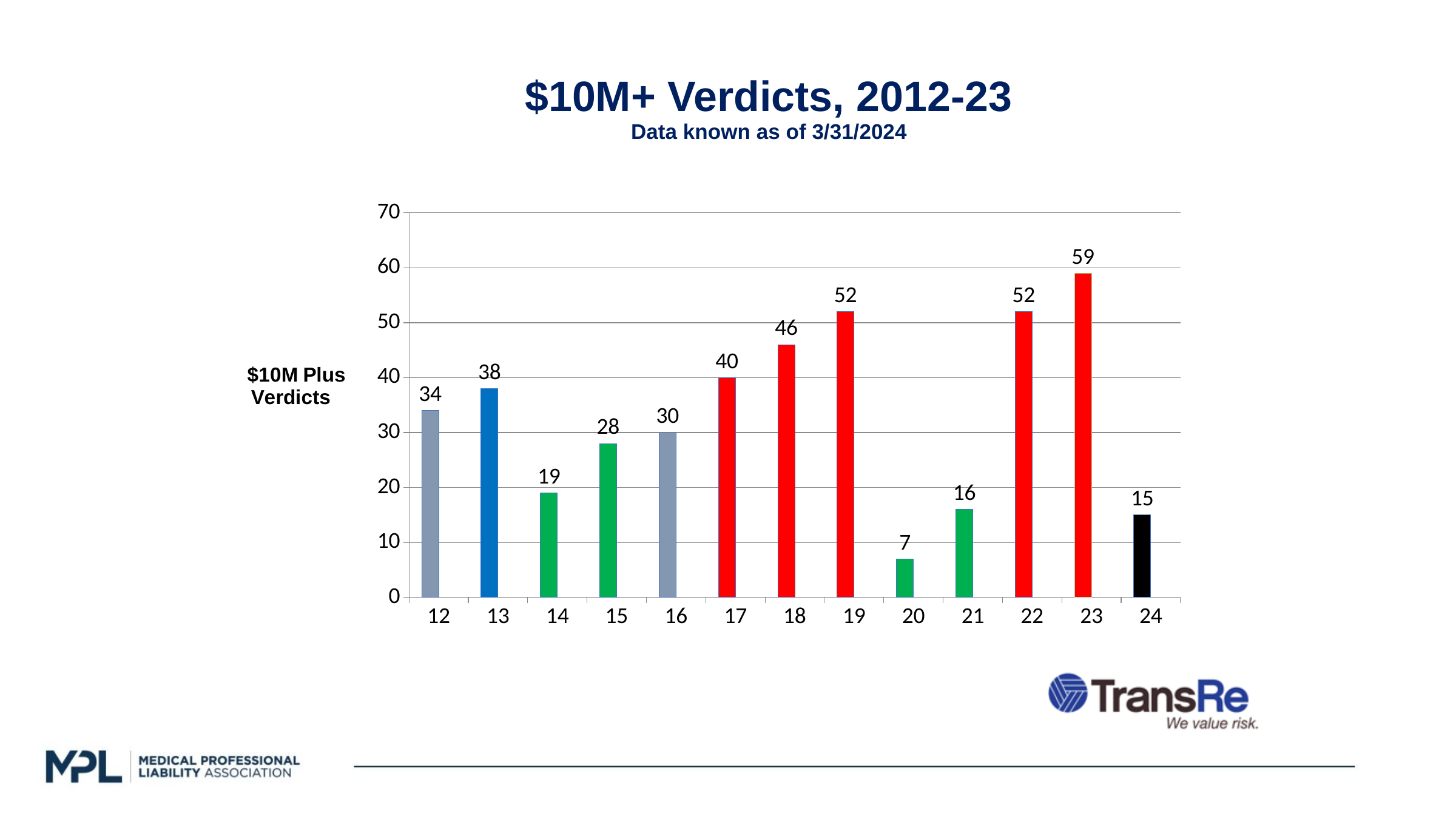
What is the difference between the values for 18 and 14? 27 What is the title of the chart? $10M+ Verdicts, 2012-23 What is the value for 16? 30 Is the value for 19 greater or less than 50? greater What is the value for 23? 59 How many categories are shown on the x axis? 13 What is the difference between the values for 23 and 22? 7 What kind of chart is shown on the slide? bar chart Which category has the highest value? 23 Which category has the lowest value? 20 What is the value for 20? 7 Which is larger, the value for 13 or the value for 15? 13